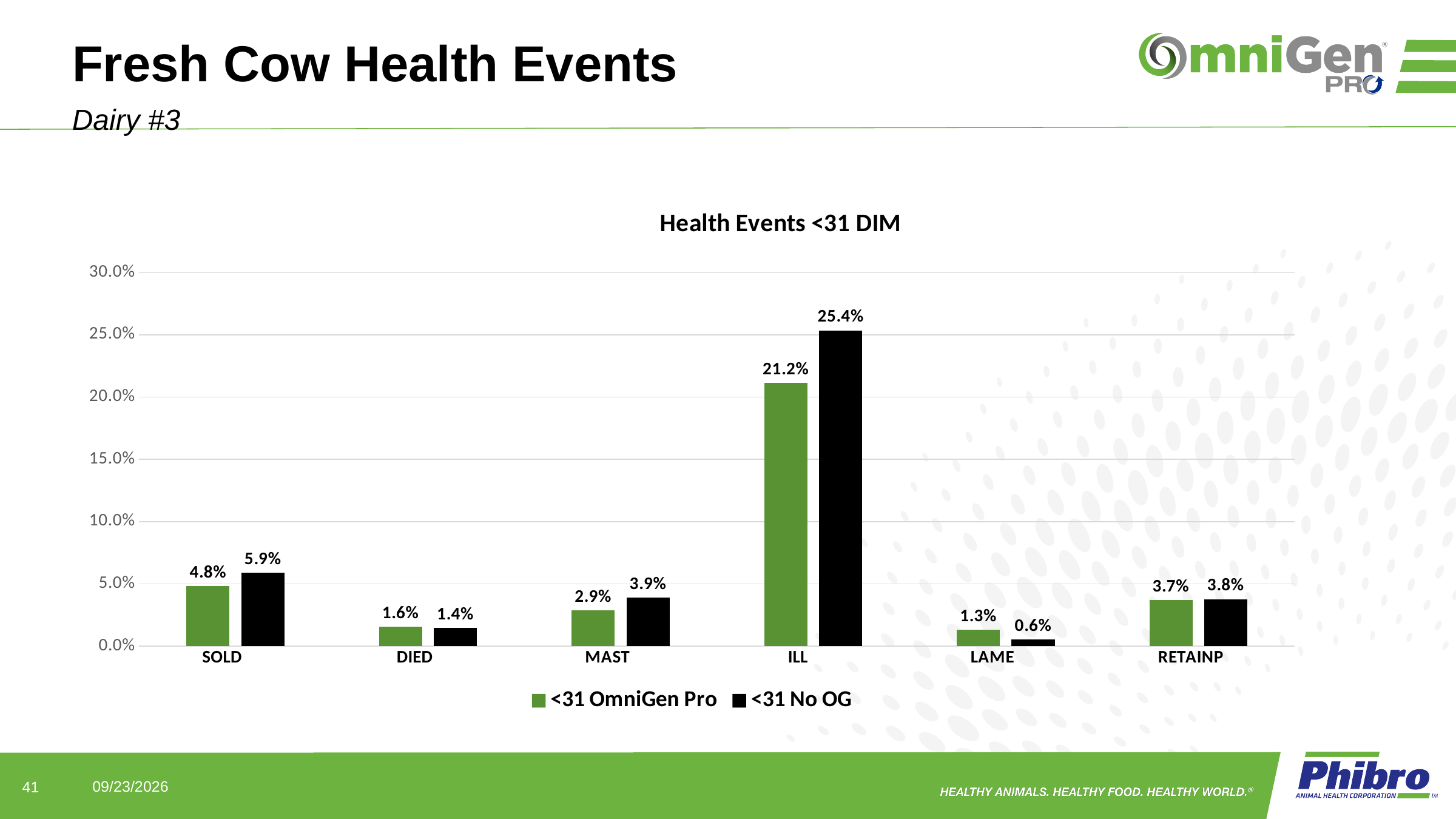
Which category has the highest value in the <31 No OG series? ILL What is the value for SOLD in the <31 No OG series? 5.9% How many categories are shown on the x axis? 6 How many series does the legend list? 2 What is the value for LAME in the <31 No OG series? 0.6% Is the value for ILL in the <31 No OG series greater or less than 25.0%? greater What is the title of the chart? Health Events <31 DIM Which category has the lowest value in the <31 OmniGen Pro series? LAME What is the value for ILL in the <31 OmniGen Pro series? 21.2% What is the difference between the <31 No OG and <31 OmniGen Pro values for ILL? 4.2% What kind of chart is shown on the slide? bar chart For MAST, which series has the larger value, <31 OmniGen Pro or <31 No OG? <31 No OG